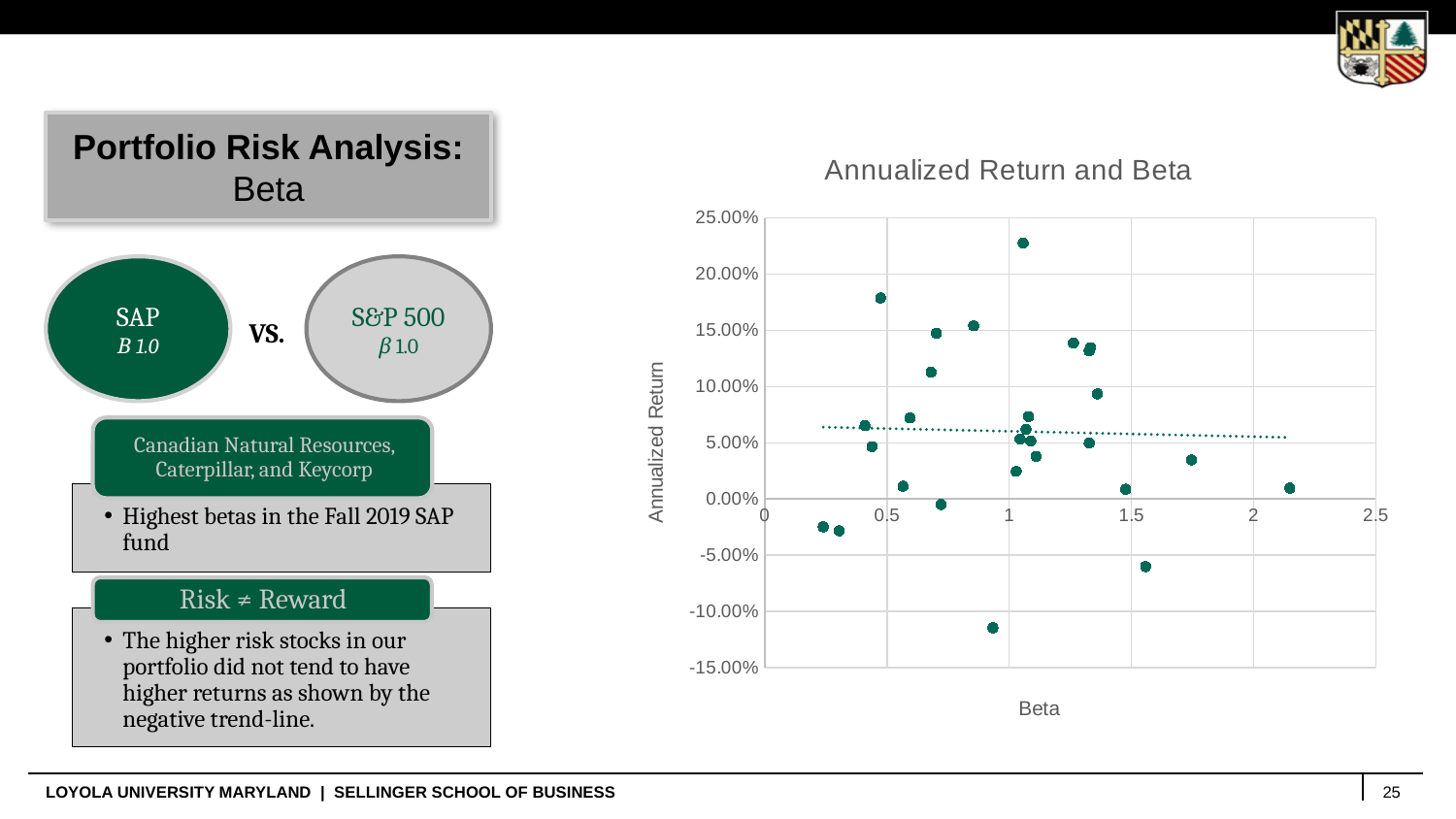
Is the Beta of the rightmost point in the chart greater or less than 2? greater Does the dotted trend line in the chart rise or fall as Beta increases? fall What is the label of the horizontal axis of the chart? Beta Is the annualized return of the highest point in the chart greater or less than 20.00%? greater Is the annualized return of the lowest point in the chart greater or less than -10.00%? less What is the title of the chart? Annualized Return and Beta What kind of chart is shown on the slide? scatter chart